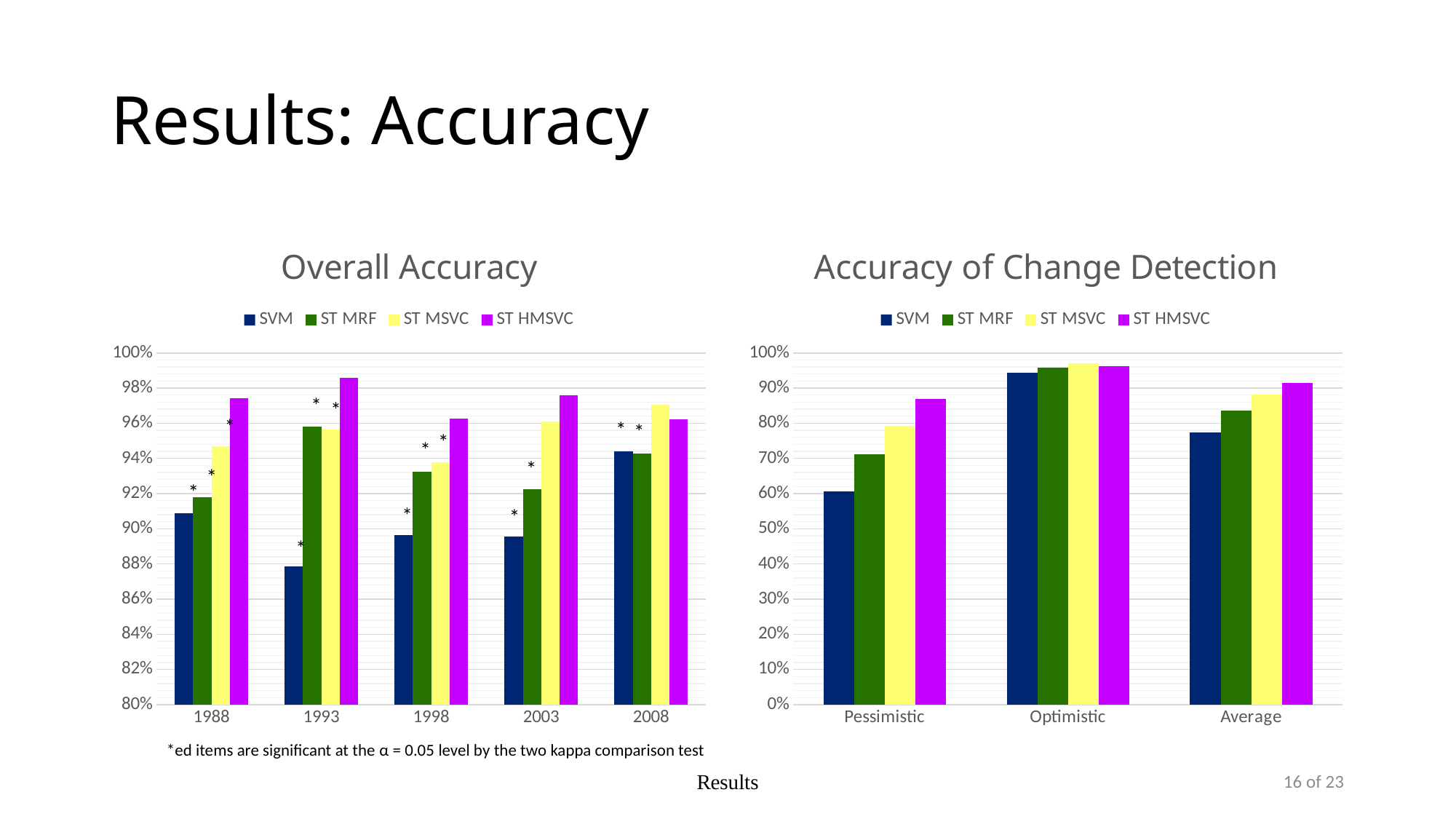
In the Overall Accuracy chart, which year has the lowest SVM value? 1993 What kind of chart is the Overall Accuracy chart? bar chart In the Accuracy of Change Detection chart, which series has the highest value in the Pessimistic category? ST HMSVC How many categories are shown on the x axis of the Accuracy of Change Detection chart? 3 How many series does the legend of the Overall Accuracy chart list? 4 In the Overall Accuracy chart, which is larger in 2003: ST MSVC or ST MRF? ST MSVC In the Accuracy of Change Detection chart, is the value for SVM in the Pessimistic category greater or less than 70%? less In the Overall Accuracy chart, which series has the highest value in 1988? ST HMSVC What is the title of the chart on the right side of the slide? Accuracy of Change Detection In the Overall Accuracy chart, is the value for ST HMSVC in 1993 greater or less than 98%? greater In the Overall Accuracy chart, is the value for SVM in 1993 greater or less than 90%? less How many years are shown on the x axis of the Overall Accuracy chart? 5